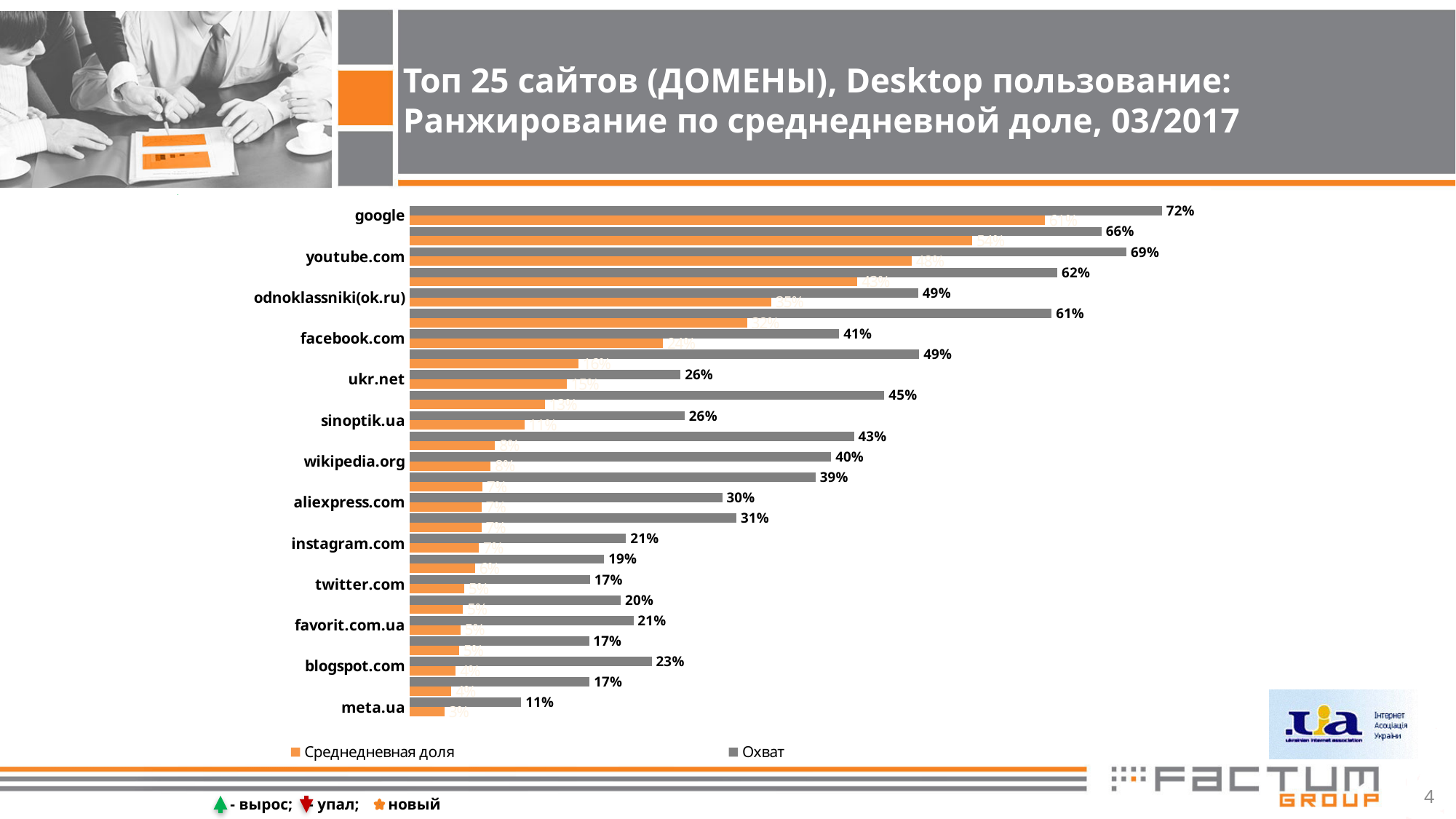
Which labelled site has the highest Охват value? google What kind of chart is shown on the slide? bar chart What is the Охват value for google? 72% What is the Охват value for blogspot.com? 23% What is the difference between the Охват values for odnoklassniki(ok.ru) and facebook.com? 8% Which labelled site has the lowest Охват value? meta.ua How many series does the legend list? 2 What are the two legend entries of the chart? Среднедневная доля, Охват What is the difference between the Охват values for google and youtube.com? 3% Which has the larger Охват value, wikipedia.org or aliexpress.com? wikipedia.org What is the Охват value for facebook.com? 41% What is the Охват value for meta.ua? 11%